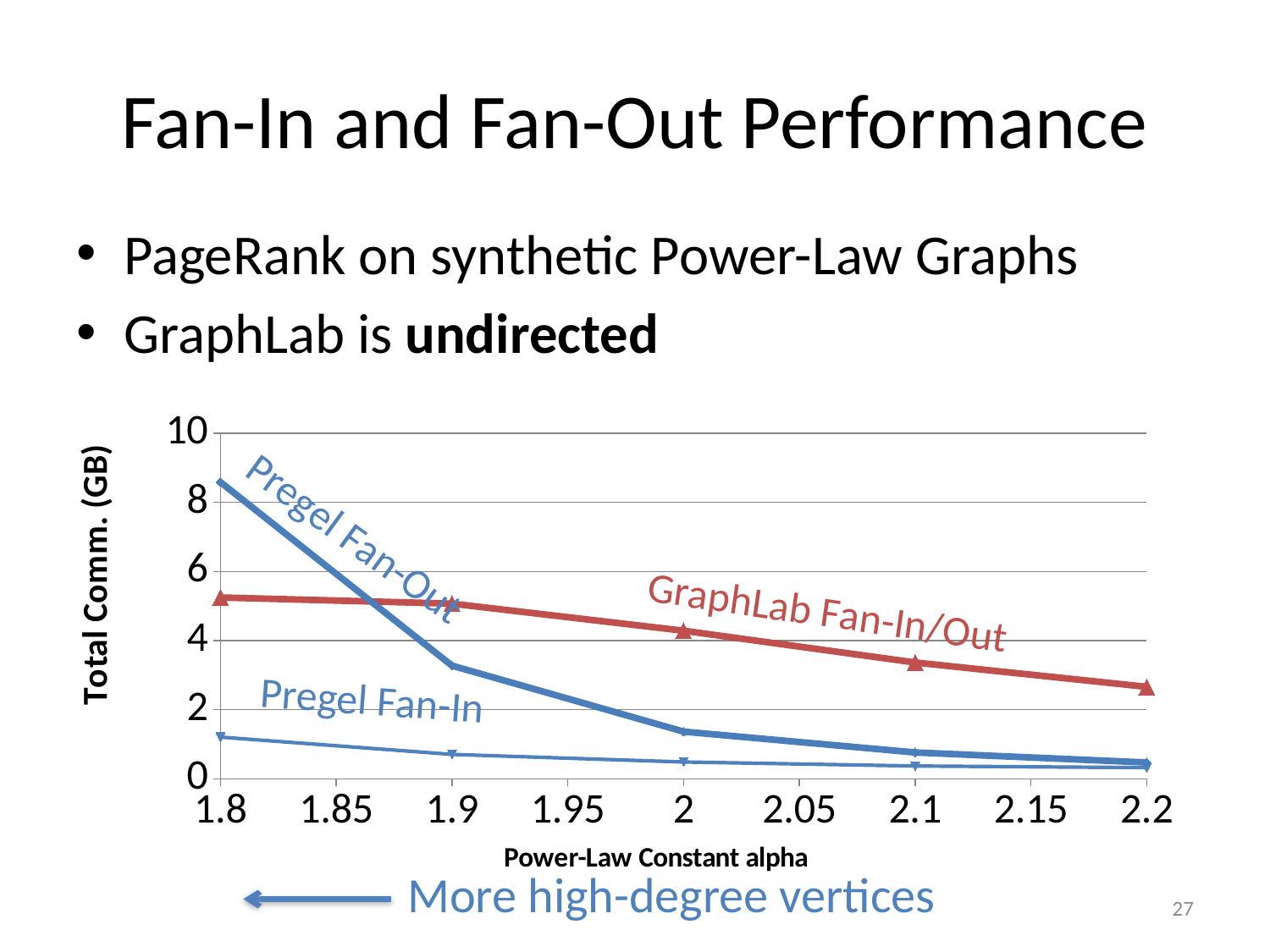
How many data points does the Pregel Fan-Out series have? 5 Which series has the lowest value at alpha = 1.8? Pregel Fan-In What is the label of the x axis? Power-Law Constant alpha At alpha = 2, which is larger: GraphLab Fan-In/Out or Pregel Fan-Out? GraphLab Fan-In/Out Which series has the highest value at alpha = 1.8? Pregel Fan-Out Is the value for Pregel Fan-Out at alpha = 1.8 greater or less than 8? greater How many series are plotted in the chart? 3 What is the label of the y axis? Total Comm. (GB) What kind of chart is shown on the slide? line chart Does the Pregel Fan-Out series rise or fall as alpha increases from 1.8 to 2.2? fall Is the value for GraphLab Fan-In/Out at alpha = 2.2 greater or less than 2? greater Is the value for Pregel Fan-In at alpha = 1.8 greater or less than 2? less